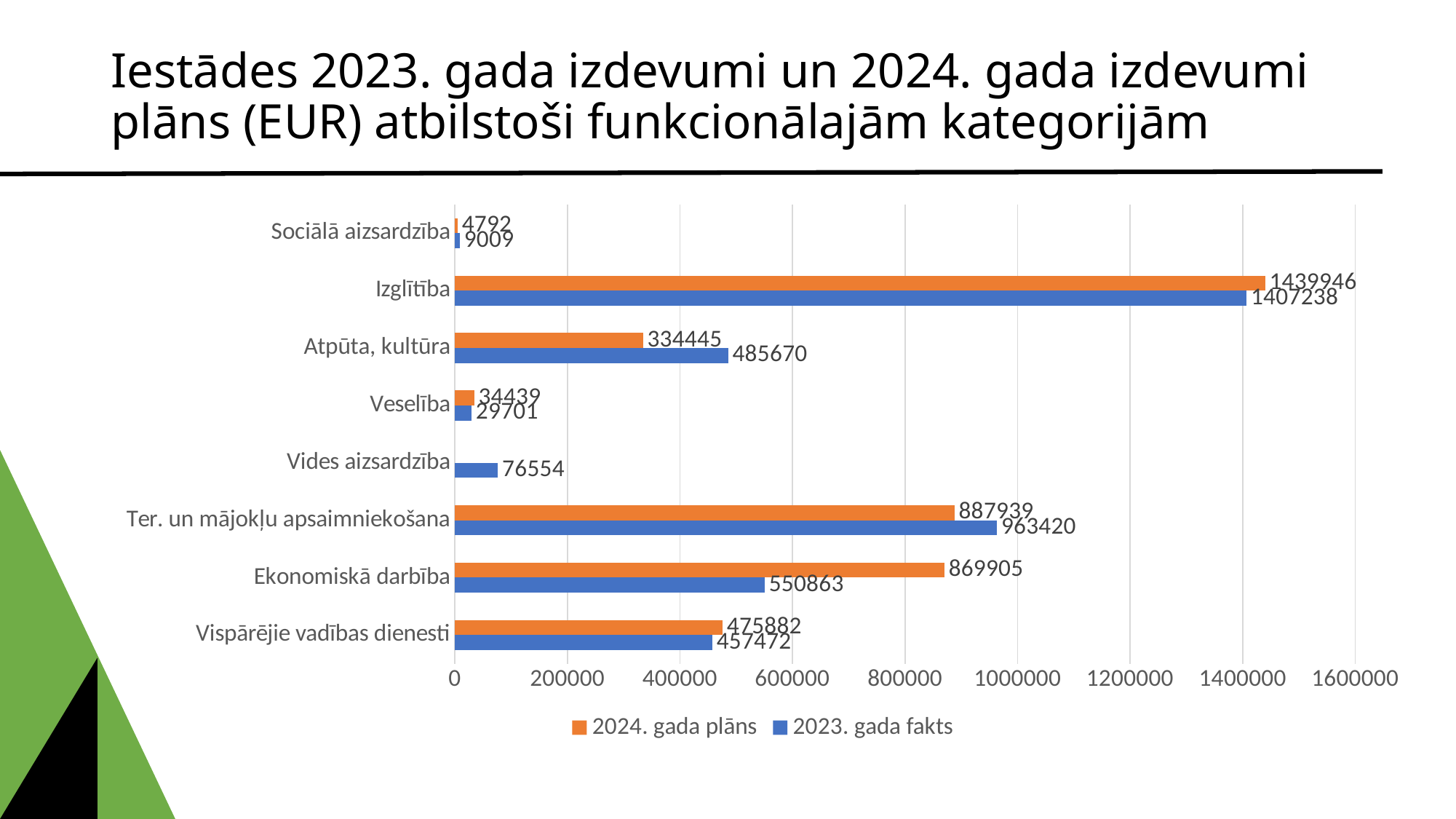
How many categories are shown on the chart? 8 What is the difference between the 2024. gada plāns and 2023. gada fakts values for Ekonomiskā darbība? 319042 Which colour represents the 2024. gada plāns series in the chart? orange How many series does the legend list? 2 What kind of chart is shown on the slide? bar chart What is the 2024. gada plāns value for Izglītība? 1439946 What is the 2023. gada fakts value for Vides aizsardzība? 76554 Is the 2024. gada plāns value for Vispārējie vadības dienesti greater or less than 400000? greater Which category has the highest 2023. gada fakts value? Izglītība Which category has the lowest 2024. gada plāns value? Sociālā aizsardzība What is the 2023. gada fakts value for Atpūta, kultūra? 485670 For Ter. un mājokļu apsaimniekošana, which is larger: the 2024. gada plāns value or the 2023. gada fakts value? 2023. gada fakts